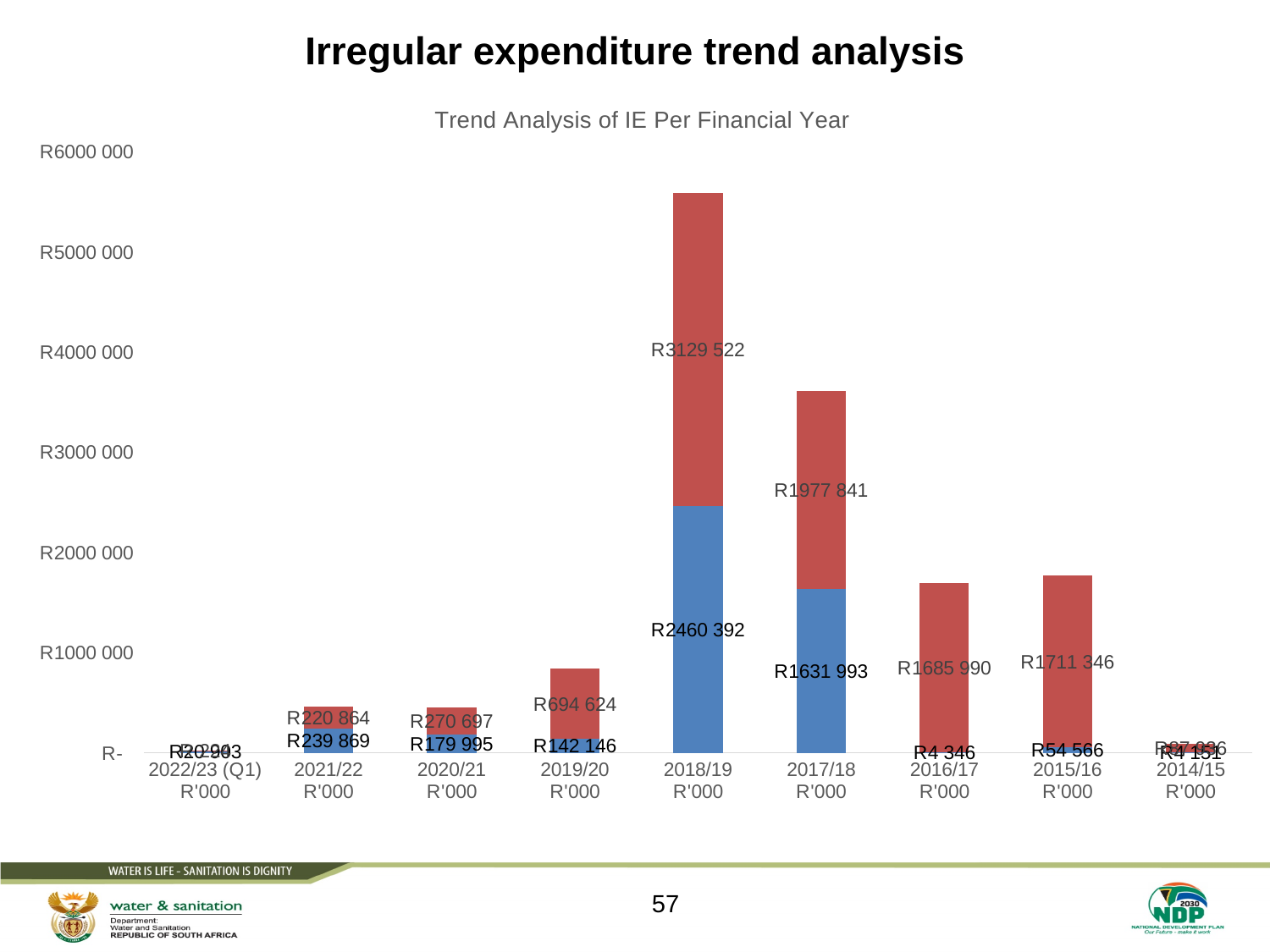
What is the value of the red (upper) segment for 2018/19? R3129 522 Which financial year has the tallest stacked bar? 2018/19 What is the value of the blue segment for 2015/16? R54 566 How many financial years are shown on the x axis? 9 Is the total stacked bar for 2017/18 greater or less than R3000 000? greater What is the title of the chart? Trend Analysis of IE Per Financial Year What is the difference between the red segment and the blue segment for 2017/18? R345 848 What is the total of the stacked bar for 2018/19? R5589 914 What is the value of the blue (lower) segment for 2018/19? R2460 392 What is the value of the red segment for 2019/20? R694 624 What kind of chart is shown on the slide? Stacked bar chart Which is larger: the red segment for 2015/16 or the red segment for 2016/17? 2015/16